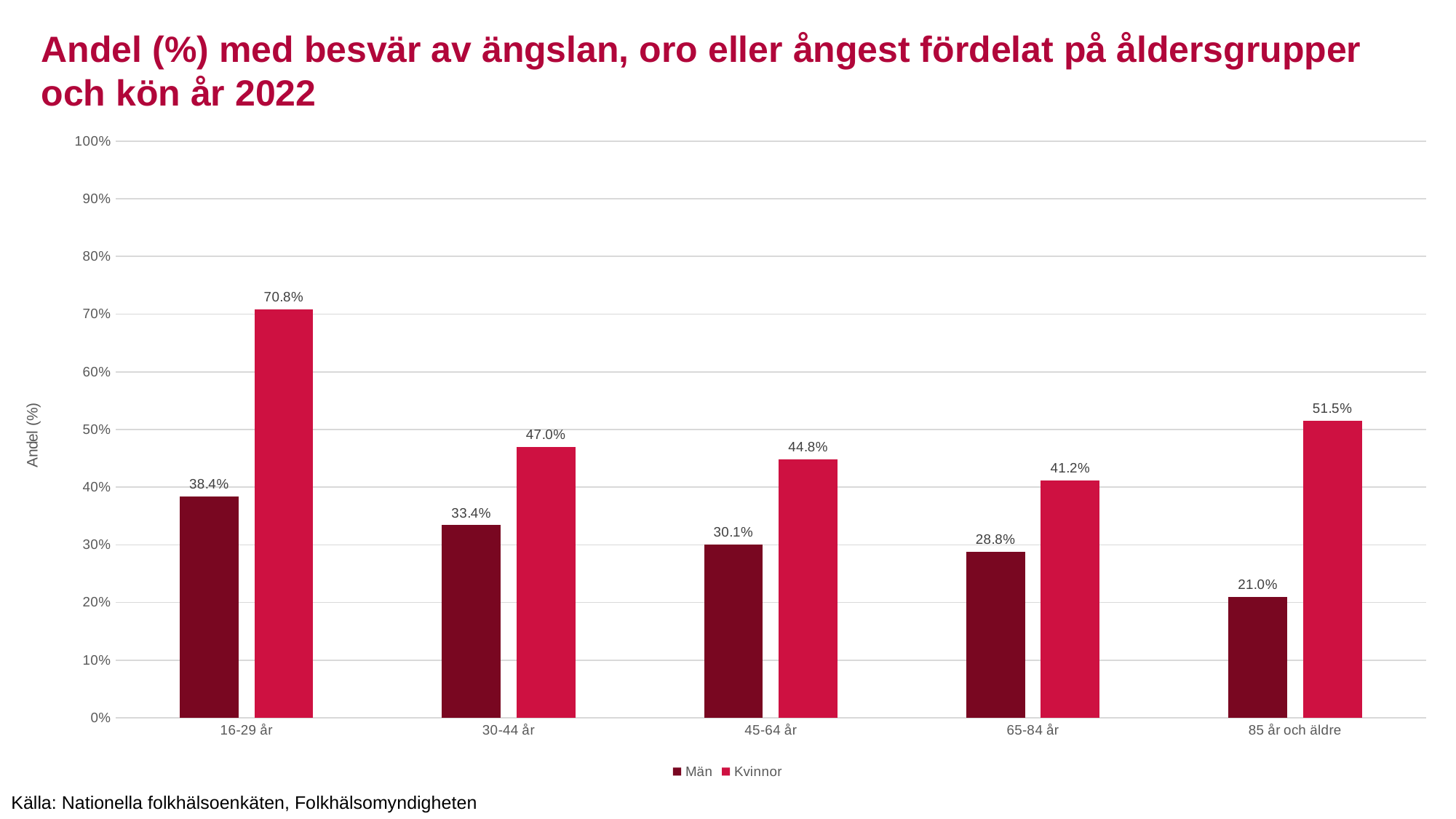
What is the value for Kvinnor in the 16-29 år age group? 70.8% How many age groups are shown on the x axis? 5 Do the values for Män rise or fall from 16-29 år to 85 år och äldre? Fall What is the difference between Kvinnor and Män in the 30-44 år age group? 13.6 percentage points Which age group has the highest value for Kvinnor? 16-29 år How many series does the legend list? 2 What is the value for Män in the 85 år och äldre age group? 21.0% Which is larger: Kvinnor in 65-84 år or Kvinnor in 45-64 år? Kvinnor in 45-64 år What is the label of the y axis? Andel (%) Which age group has the lowest value for Män? 85 år och äldre What kind of chart is shown on the slide? Bar chart What is the value for Män in the 45-64 år age group? 30.1%